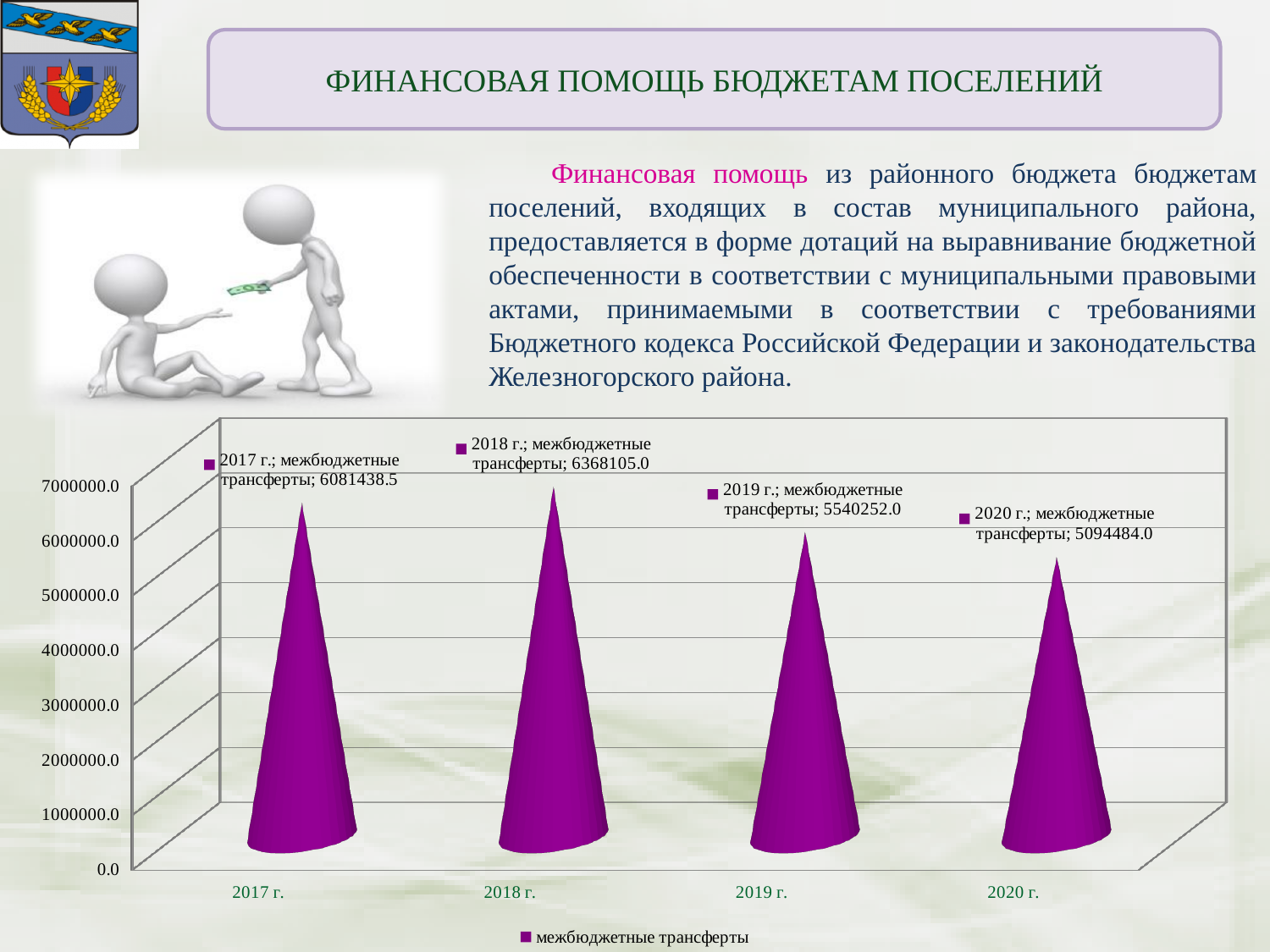
What is the value of межбюджетные трансферты for 2018 г.? 6368105.0 How many years are shown on the x axis of the chart? 4 Which year has the lowest value of межбюджетные трансферты? 2020 г. Do the values rise or fall from 2018 г. to 2020 г.? fall What is the value of межбюджетные трансферты for 2017 г.? 6081438.5 What is the difference between the values for 2018 г. and 2017 г.? 286666.5 What is the value of межбюджетные трансферты for 2020 г.? 5094484.0 Which is larger, the value for 2017 г. or the value for 2019 г.? 2017 г. How many series does the chart legend list? 1 What is the value of межбюджетные трансферты for 2019 г.? 5540252.0 Which year has the highest value of межбюджетные трансферты? 2018 г. What is the difference between the values for 2019 г. and 2020 г.? 445768.0